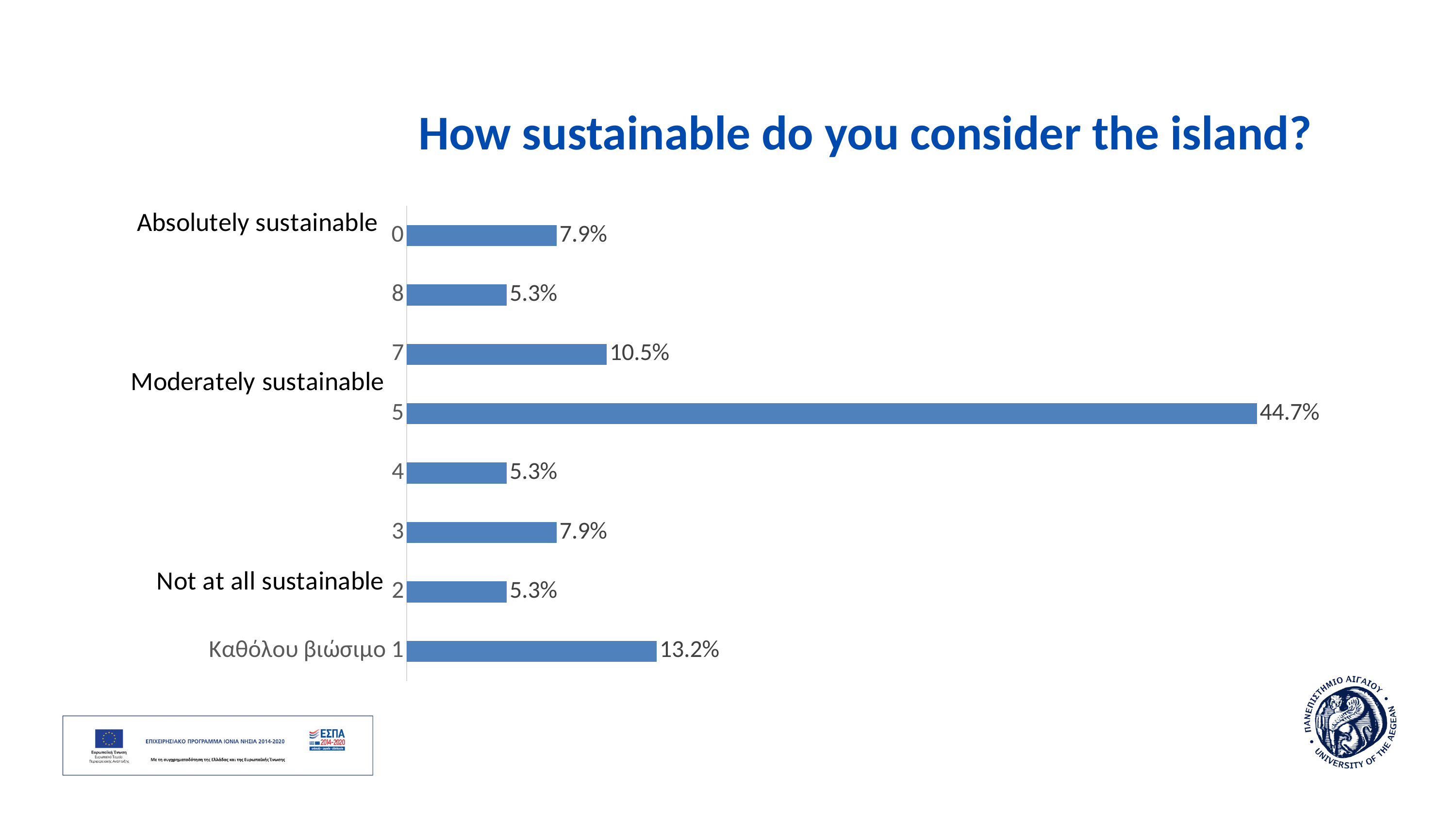
What is the value for category 3? 7.9% What is the difference between the values for category 7 and category 4? 5.2% What is the value for category 7? 10.5% What is the difference between the values for category 5 and category 1? 31.5% Which category has the highest value? 5 What is the value for category 8? 5.3% What is the title of the chart? How sustainable do you consider the island? How many bars are plotted in the chart? 8 Which is larger, the value for category 7 or the value for category 3? category 7 What is the value for category 1 (Καθόλου βιώσιμο)? 13.2% What is the value for category 5? 44.7% What kind of chart is shown on the slide? bar chart